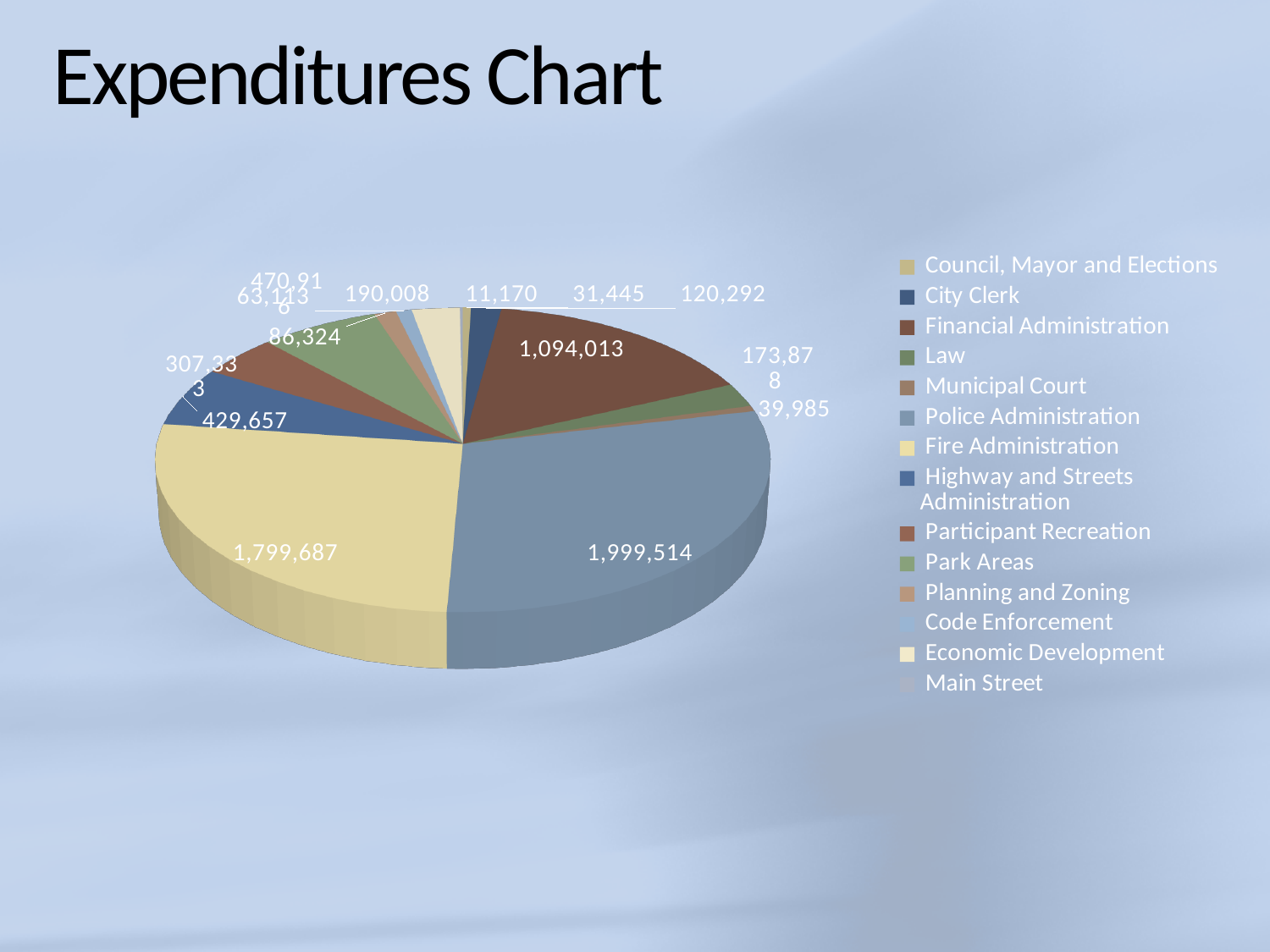
What kind of chart is shown on the slide? pie chart What is the difference between the Police Administration value and the Fire Administration value? 199,827 Which category has the largest slice of the pie? Police Administration What is the value shown for Police Administration? 1,999,514 What is the value shown for Fire Administration? 1,799,687 What is the value shown for Highway and Streets Administration? 429,657 What is the value shown for Municipal Court? 39,985 What is the title of the chart? Expenditures Chart What is the value shown for Financial Administration? 1,094,013 How many categories does the legend list? 14 What is the value shown for Law? 173,878 Which is larger, the value for Police Administration or the value for Fire Administration? Police Administration